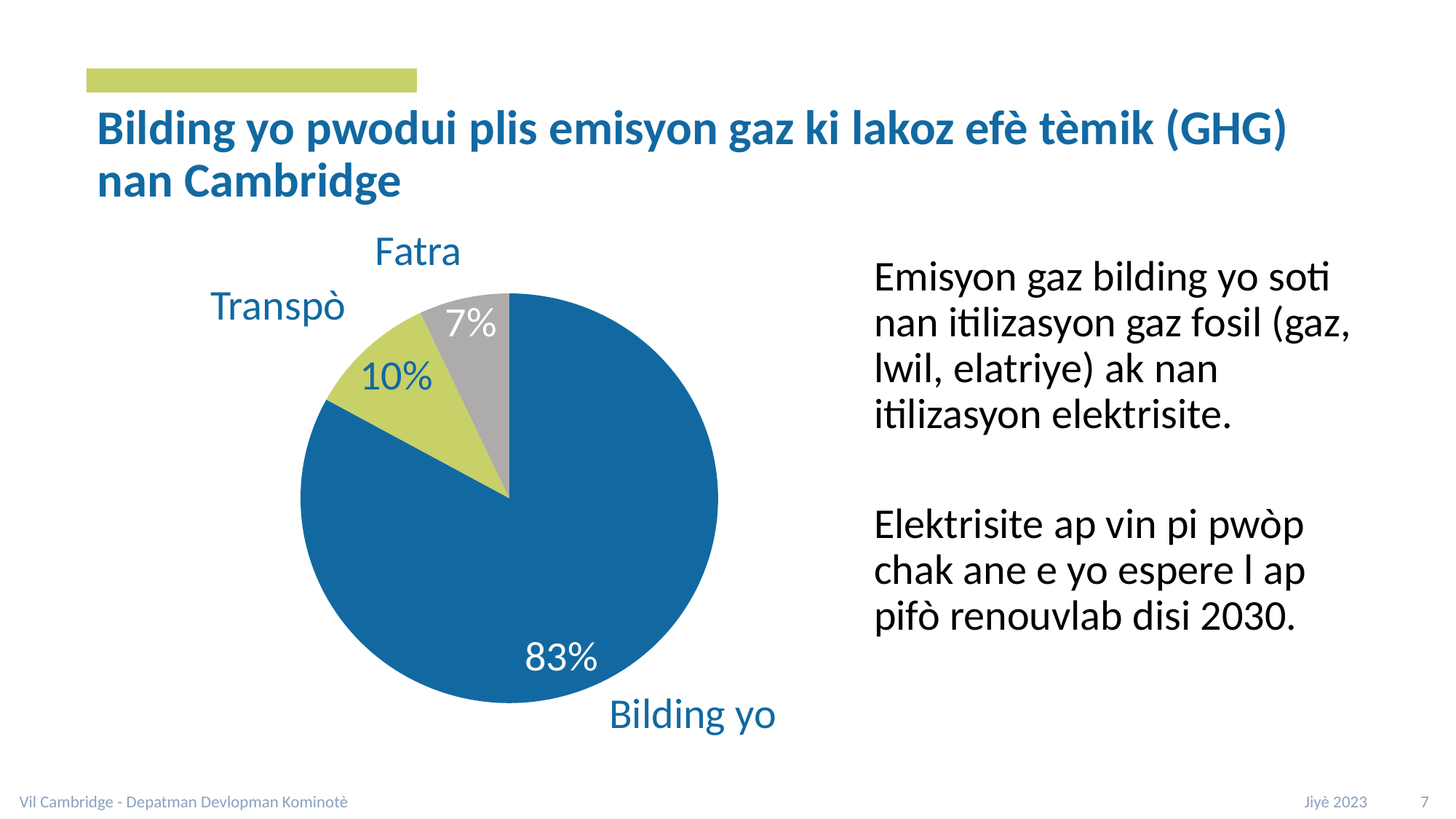
What share of the pie does Fatra have? 7% What kind of chart is shown on the slide? pie chart What is the difference in percentage points between Bilding yo and Transpò? 73 Which category has the smallest slice of the pie? Fatra How many slices does the pie chart have? 3 What share of the pie does Transpò have? 10% What share of the pie does Bilding yo have? 83% What colour is the slice for Fatra? grey Which category has the largest slice of the pie? Bilding yo Which is larger, the slice for Transpò or the slice for Fatra? Transpò What colour is the slice for Bilding yo? blue What is the difference in percentage points between Transpò and Fatra? 3